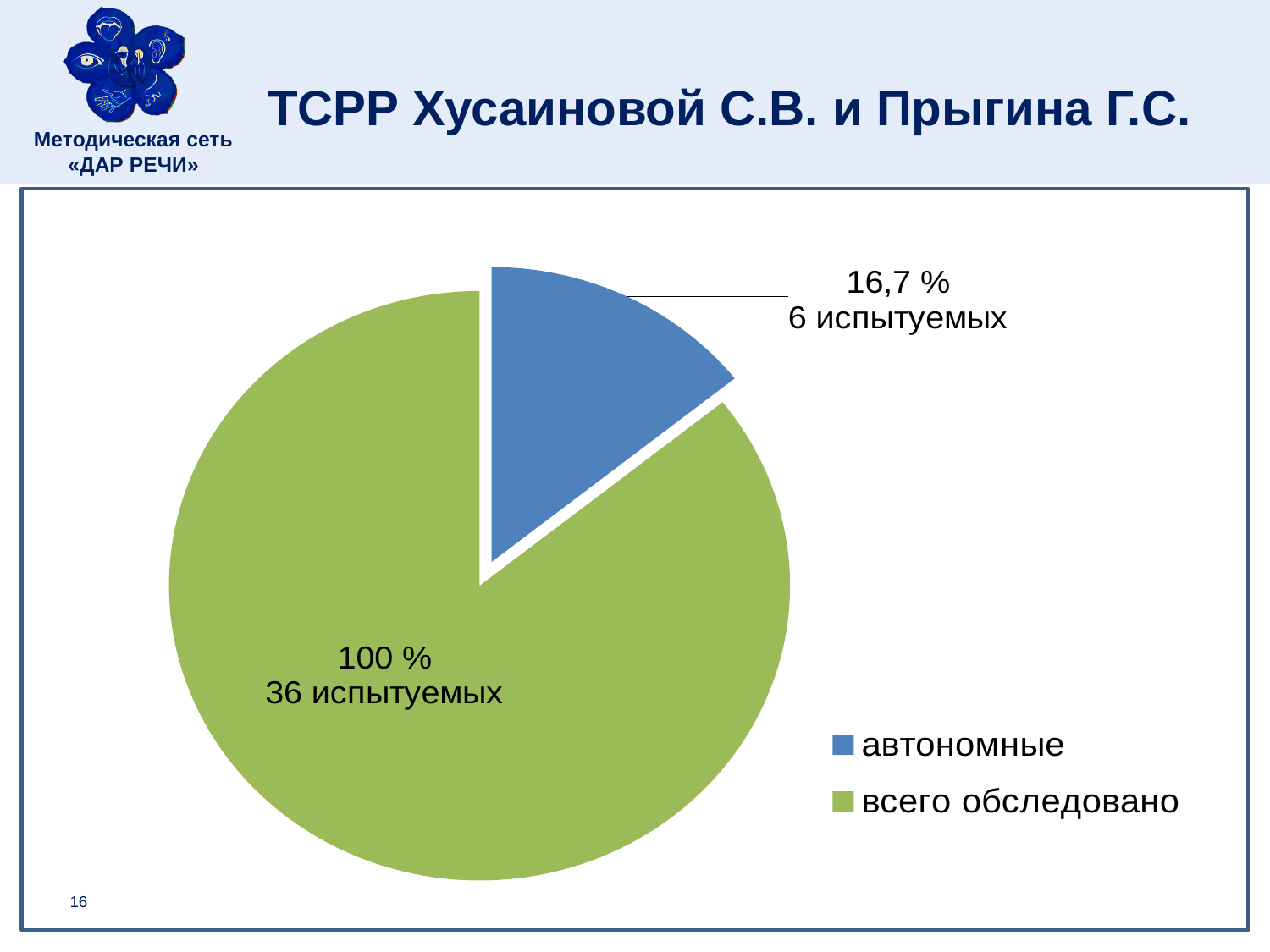
How many испытуемых are labelled for the slice «автономные»? 6 испытуемых What is the difference in испытуемых between «всего обследовано» and «автономные»? 30 испытуемых What percentage is printed next to the slice «автономные»? 16,7 % What kind of chart is shown on the slide? pie chart How many series does the legend list? 2 Which slice of the pie is the smallest? автономные What percentage is printed on the slice «всего обследовано»? 100 % How many slices does the pie chart have? 2 What colour is the slice «автономные»? blue Which slice of the pie is the largest? всего обследовано Which is larger: the number of испытуемых for «автономные» or for «всего обследовано»? всего обследовано How many испытуемых are labelled for the slice «всего обследовано»? 36 испытуемых